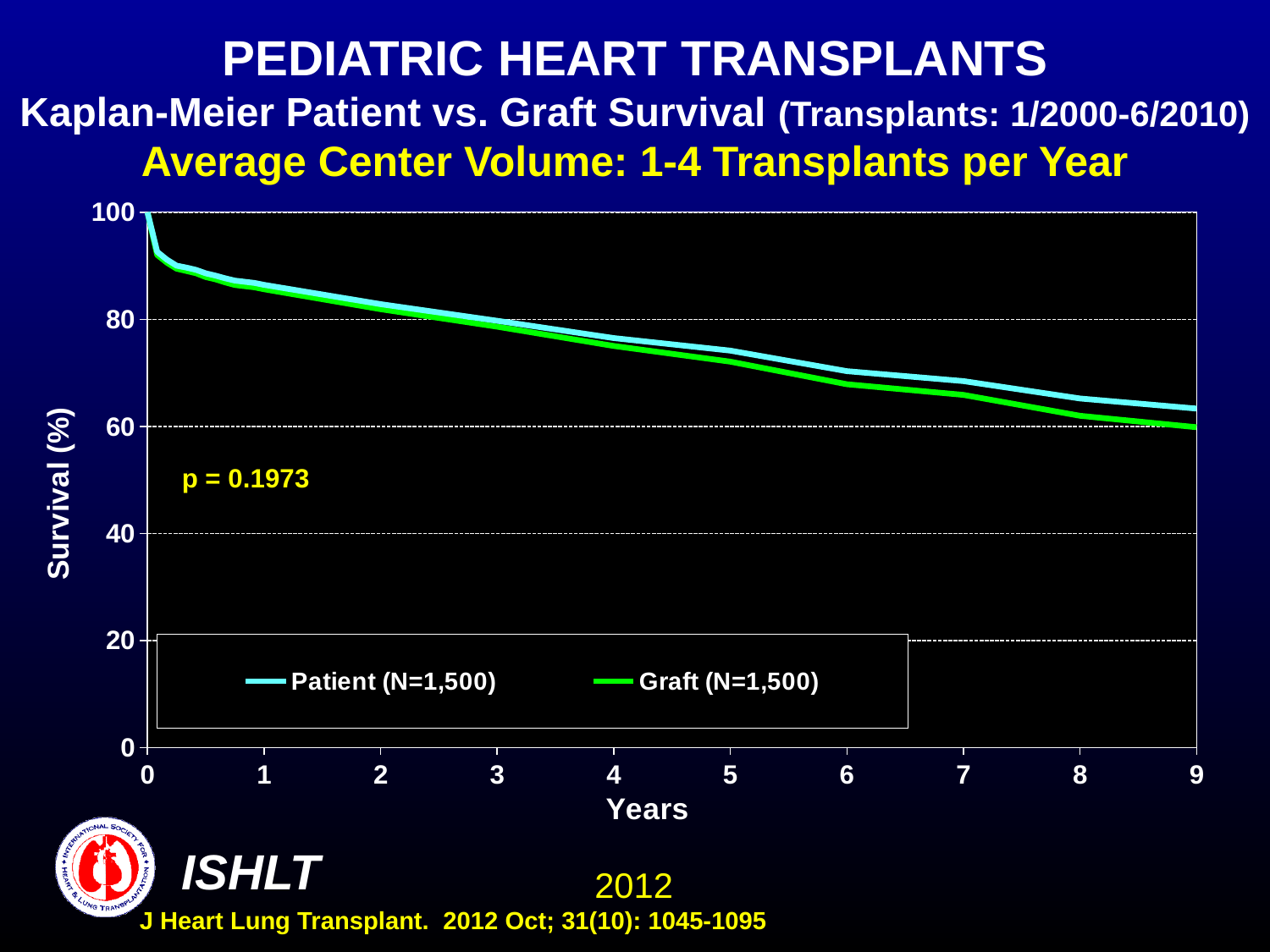
Is the Graft survival value at 5 years greater or less than 80? less What is the N given for the Patient series in the legend? N=1,500 Do the survival curves rise or fall as years increase? fall What kind of chart is shown on the slide? line chart Is the Patient survival value at 9 years greater or less than 60? greater Is the Graft survival value at 7 years greater or less than 60? greater At 8 years, which series has the higher survival, Patient or Graft? Patient What p-value is printed on the chart? p = 0.1973 How many series does the legend list? 2 At 6 years, which series has the lower survival, Patient or Graft? Graft